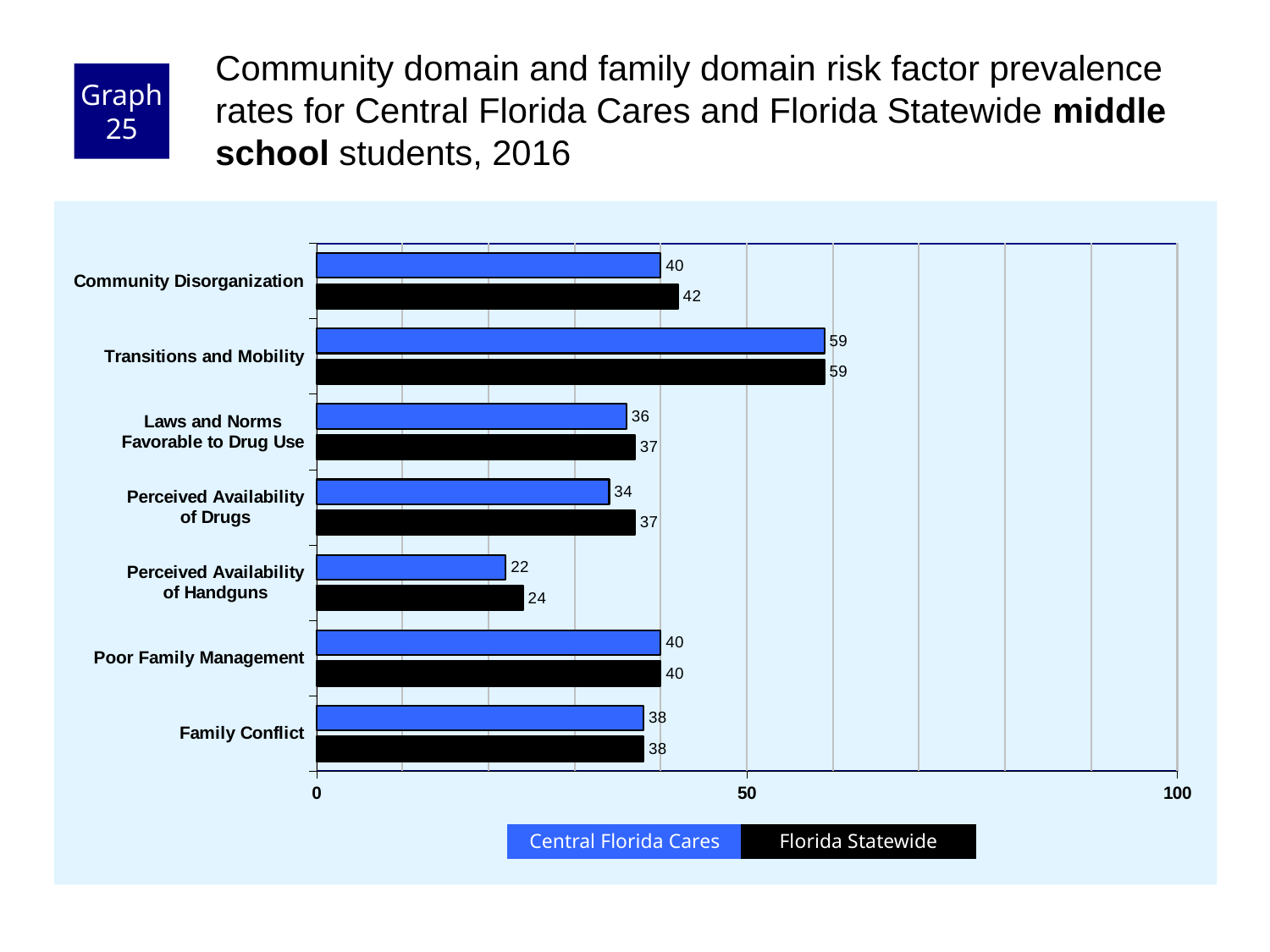
What is the Central Florida Cares value for Perceived Availability of Drugs? 34 What is the difference between the Florida Statewide and Central Florida Cares values for Perceived Availability of Drugs? 3 Which is larger for Community Disorganization: the Central Florida Cares value or the Florida Statewide value? Florida Statewide Which risk factor has the highest Central Florida Cares value? Transitions and Mobility What kind of chart is shown on the slide? bar chart What is the Central Florida Cares value for Transitions and Mobility? 59 How many series does the legend list? 2 How many risk factors are shown on the chart? 7 What is the Florida Statewide value for Perceived Availability of Handguns? 24 Which risk factor has the lowest Florida Statewide value? Perceived Availability of Handguns Is the Central Florida Cares value for Transitions and Mobility greater or less than 50? greater Which series is shown in black in the legend? Florida Statewide